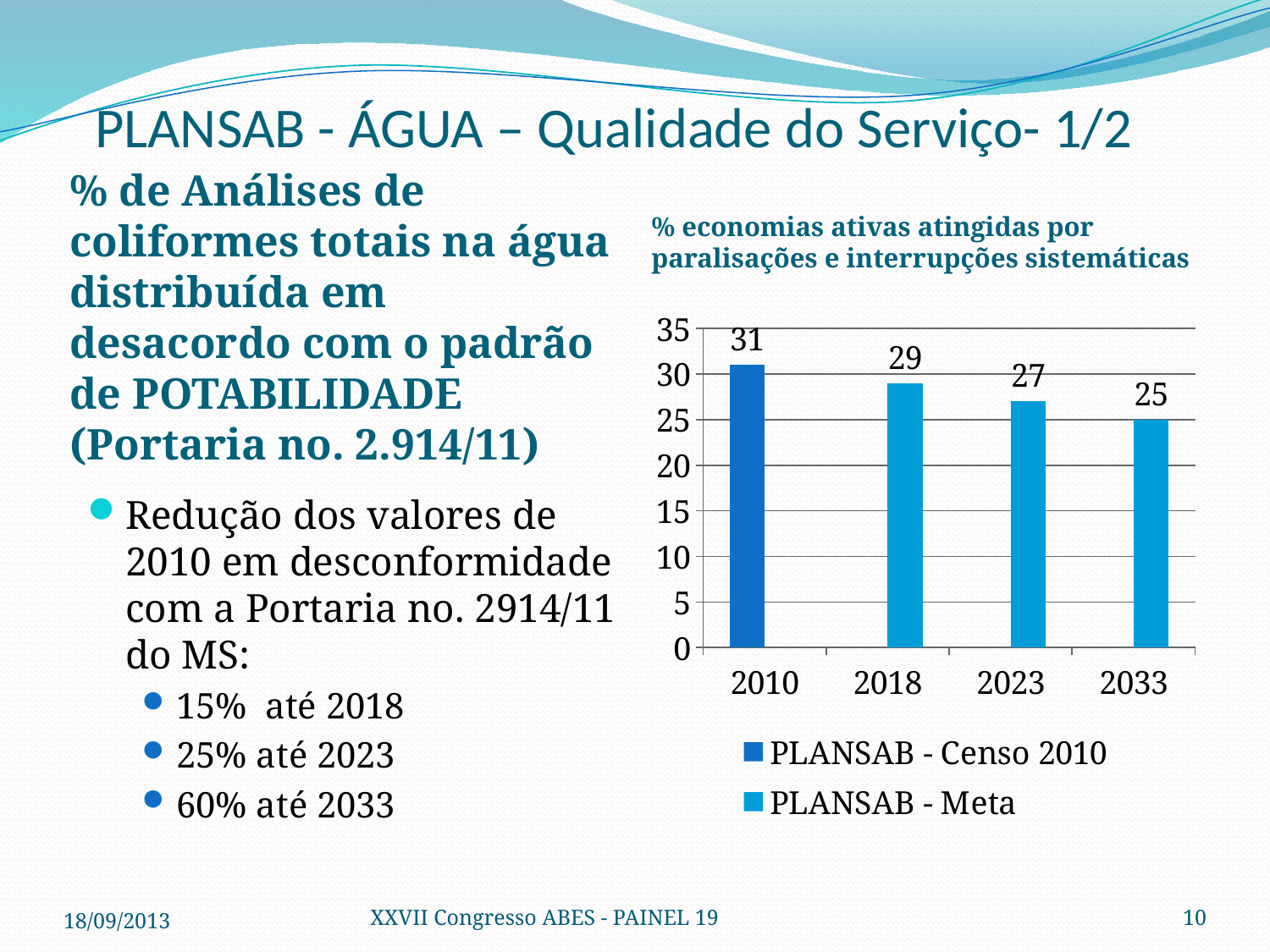
What kind of chart is shown on the slide? Bar chart Which is larger, the value for 2018 or the value for 2023? 2018 Is the value for 2018 greater or less than 25? greater What is the value for 2010 in the chart? 31 How many series does the chart legend list? 2 What is the value for 2033 in the chart? 25 How many years are shown on the x axis of the chart? 4 Which year has the highest value in the chart? 2010 What is the value for 2023 in the chart? 27 Do the values rise or fall from 2010 to 2033? Fall What is the difference between the values for 2010 and 2033? 6 Which year has the lowest value in the chart? 2033